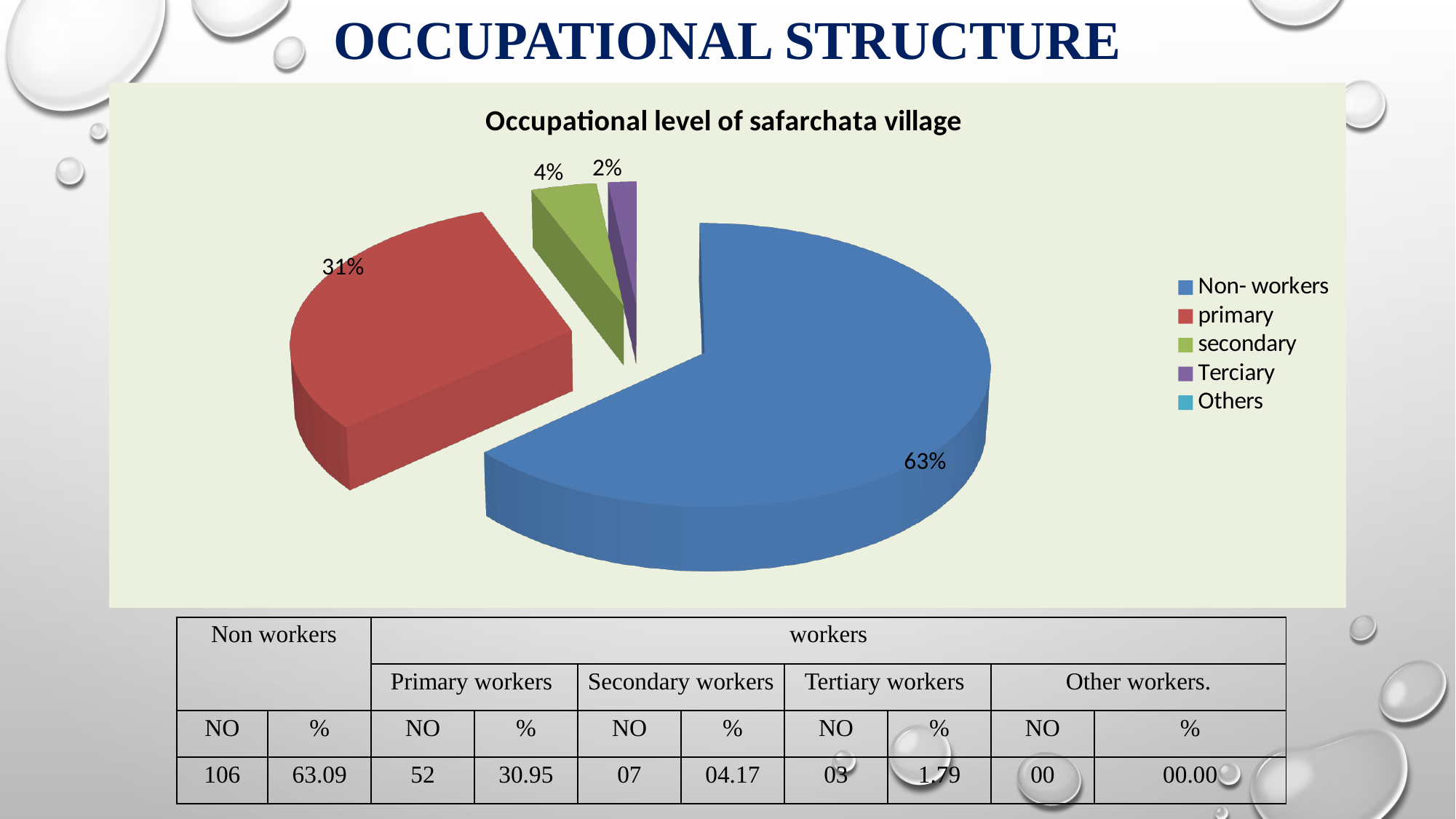
Which category has the largest slice of the pie? Non- workers How many entries does the legend list? 5 What percentage of the pie is labelled for primary? 31% What percentage of the pie is labelled for Non- workers? 63% Which labelled slice is the smallest in the pie? Terciary What is the title of the chart? Occupational level of safarchata village Which slice is larger, secondary or Terciary? secondary What percentage of the pie is labelled for secondary? 4% What colour is the Non- workers slice in the pie chart? Blue What percentage of the pie is labelled for Terciary? 2% What is the difference in percentage points between the Non- workers slice and the primary slice? 32% What type of chart is shown on the slide? Pie chart